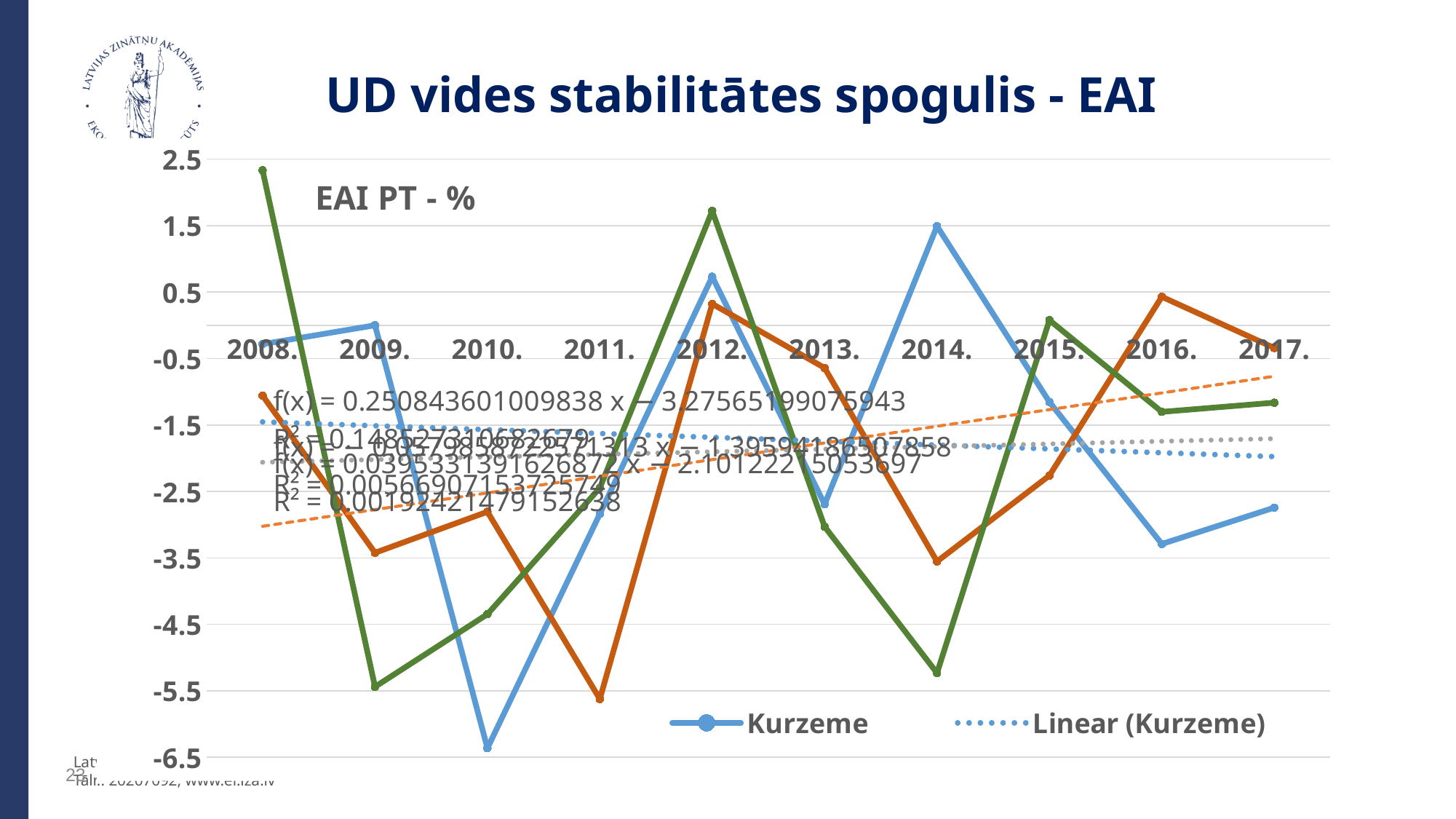
Is the Kurzeme value for 2014 greater or less than 0.5? greater Does the Linear (Kurzeme) trendline rise or fall from 2008 to 2017? fall What is the title shown inside the chart area? EAI PT - % How many years are shown along the x axis of the chart? 10 Is the Kurzeme value for 2016 greater or less than -2.5? less Which is larger for Kurzeme, the value in 2012 or the value in 2013? 2012 In which year does the Kurzeme series reach its lowest value? 2010. What kind of chart is shown on the slide? line chart Is the Kurzeme value for 2010 greater or less than -5.5? less In which year does the Kurzeme series reach its highest value? 2014. Which legend entry is drawn as a dotted line? Linear (Kurzeme) How many entries does the chart legend list? 2